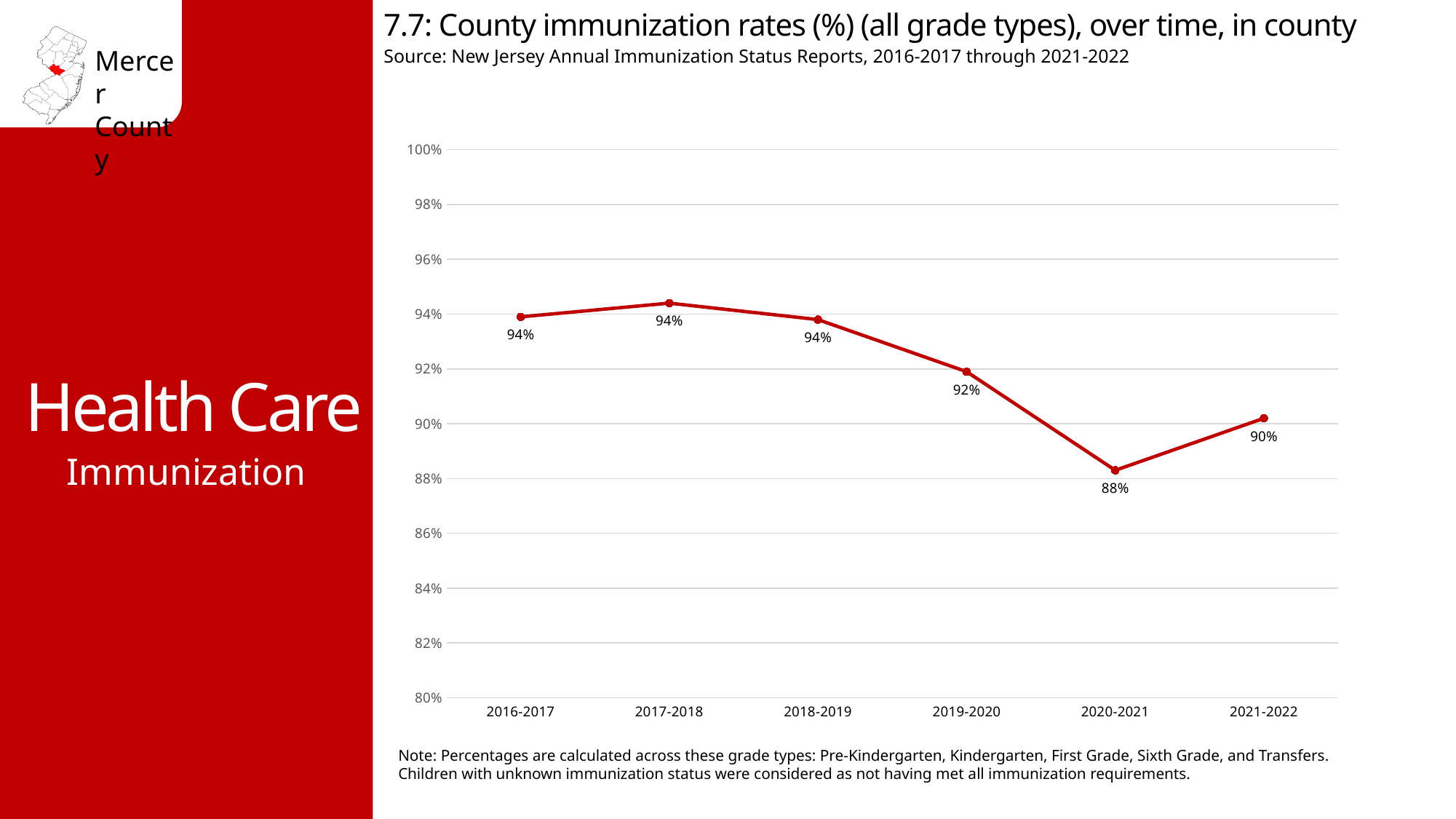
Is the value for 2020-2021 greater or less than 90%? less What is the county immunization rate for 2020-2021? 88% What is the county immunization rate for 2016-2017? 94% Do the immunization rates rise or fall from 2017-2018 to 2020-2021? fall What is the difference in percentage points between the 2019-2020 rate and the 2020-2021 rate? 4 What kind of chart is shown on the slide? line chart How many school years are plotted on the chart? 6 What is the county immunization rate for 2019-2020? 92% Which is larger, the immunization rate for 2019-2020 or for 2021-2022? 2019-2020 Which school year has the lowest immunization rate? 2020-2021 Is the value for 2018-2019 greater or less than 92%? greater What is the county immunization rate for 2021-2022? 90%